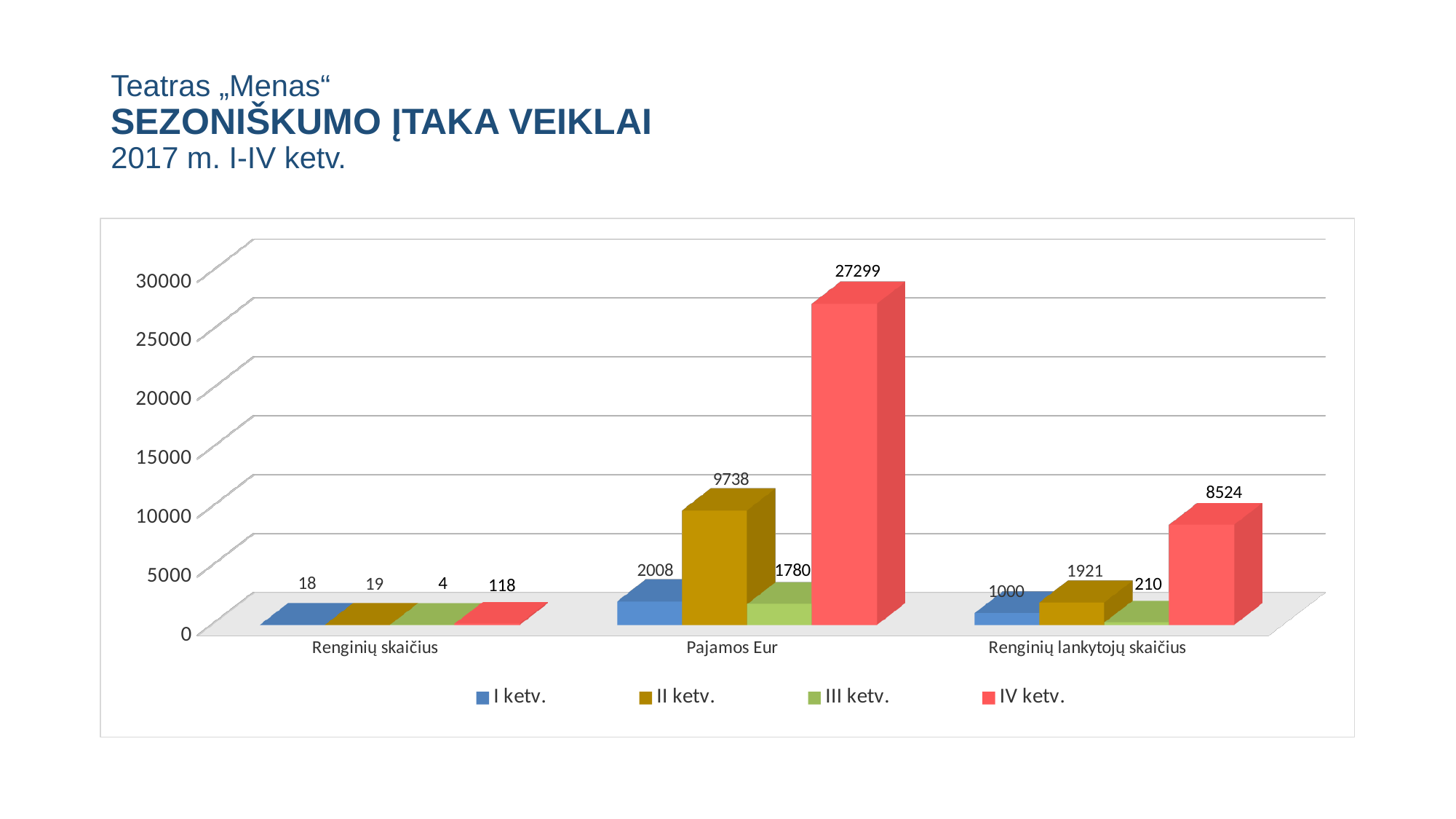
Which quarter has the lowest value in the Renginių lankytojų skaičius category? III ketv. Is the value for IV ketv. in the Pajamos Eur category greater or less than 25000? greater How many series does the legend list? 4 Which quarter has the highest value in the Pajamos Eur category? IV ketv. What is the difference between the IV ketv. and II ketv. values in the Pajamos Eur category? 17561 What is the value for IV ketv. in the Pajamos Eur category? 27299 Which is larger in the Renginių lankytojų skaičius category: I ketv. or II ketv.? II ketv. What is the value for II ketv. in the Renginių lankytojų skaičius category? 1921 What kind of chart is shown on the slide? Bar chart How many categories are shown on the x axis? 3 What colour represents IV ketv. in the legend? Red What is the value for III ketv. in the Renginių skaičius category? 4